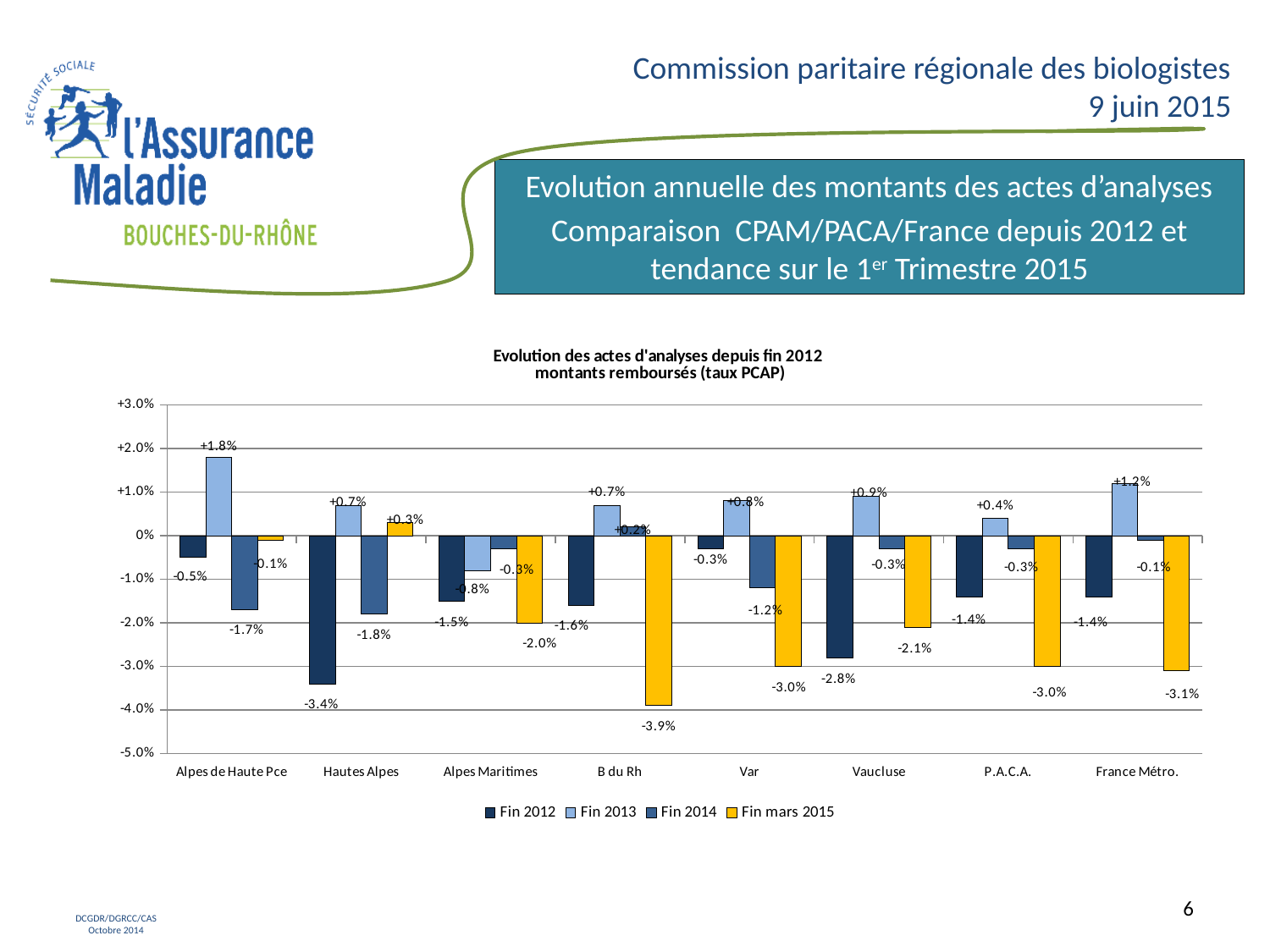
What is the Fin mars 2015 value for France Métro.? -3.1% What is the Fin 2013 value for Alpes de Haute Pce? +1.8% How many series does the legend list? 4 Which category has the highest Fin 2013 value? Alpes de Haute Pce How many categories are shown on the x axis? 8 Is the Fin 2012 value for Vaucluse larger or smaller than the Fin 2012 value for Var? smaller What kind of chart is shown on the slide? bar chart Which category has the lowest Fin 2012 value? Hautes Alpes What is the difference between the Fin 2013 value for France Métro. and the Fin 2013 value for P.A.C.A.? 0.8 percentage points What is the Fin 2012 value for Hautes Alpes? -3.4% Which category has the lowest Fin mars 2015 value? B du Rh What is the Fin mars 2015 value for B du Rh? -3.9%